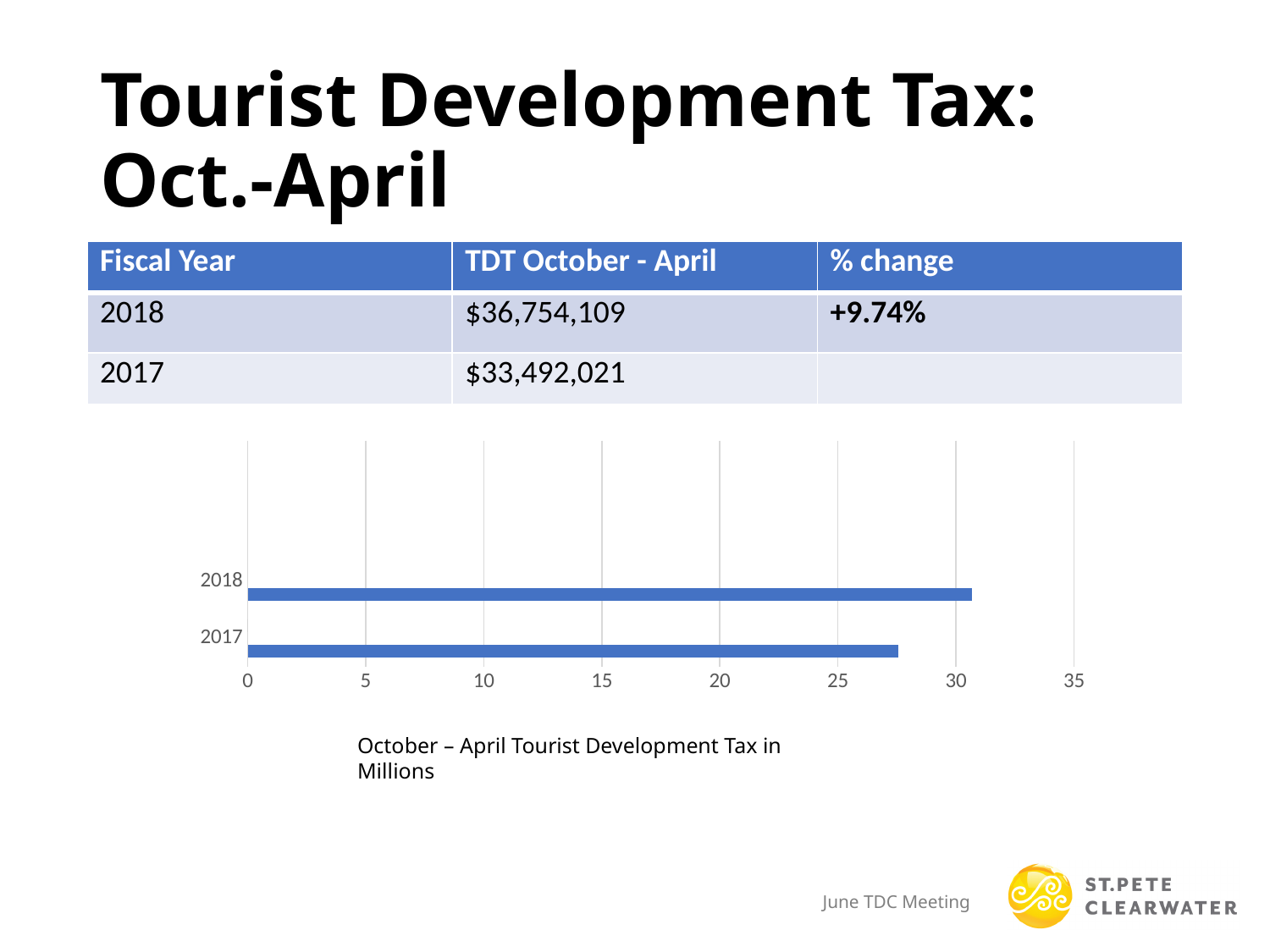
Is the bar for 2017 greater or less than 25? greater Is the bar for 2018 longer or shorter than the bar for 2017? longer Is the bar for 2018 greater or less than 35? less How many fiscal years are plotted in the bar chart? 2 What kind of chart is shown on the slide? bar chart Is the bar for 2018 greater or less than 25? greater What is the highest value shown on the chart's horizontal axis? 35 Which fiscal year has the shorter bar in the chart? 2017 Which fiscal year has the longer bar in the chart? 2018 What caption appears below the bar chart? October – April Tourist Development Tax in Millions